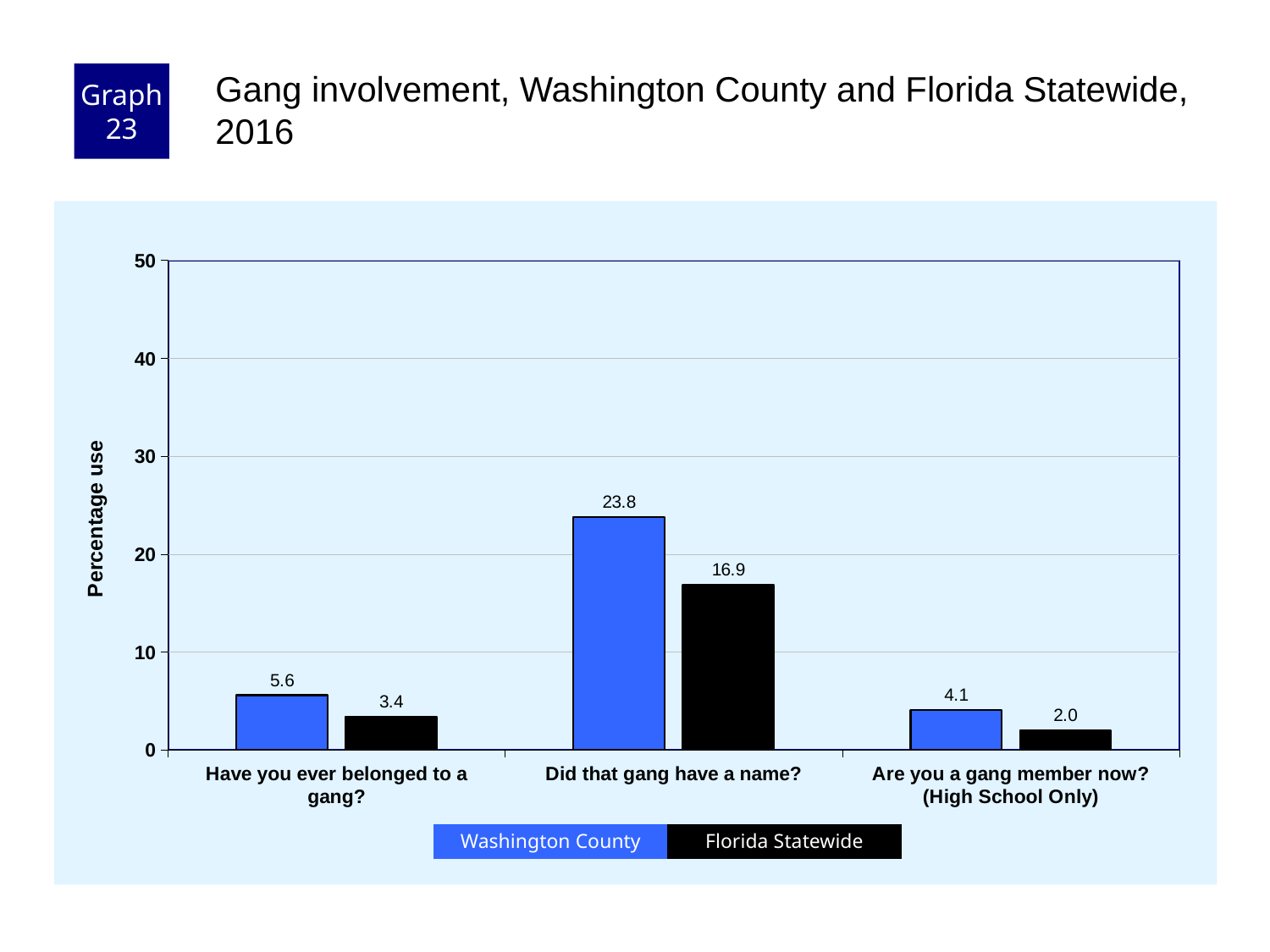
What is the Washington County value for "Did that gang have a name?"? 23.8 What is the Florida Statewide value for "Have you ever belonged to a gang?"? 3.4 How many survey questions (categories) are shown on the x axis? 3 How many series does the legend list? 2 What is the difference between the Washington County and Florida Statewide values for "Did that gang have a name?"? 6.9 What is the label of the y axis? Percentage use Which question has the highest Washington County value? Did that gang have a name? What kind of chart is shown on the slide? Bar chart For "Have you ever belonged to a gang?", which is larger: Washington County or Florida Statewide? Washington County Which question has the lowest Florida Statewide value? Are you a gang member now? (High School Only) What is the Florida Statewide value for "Are you a gang member now? (High School Only)"? 2.0 Is the Washington County value for "Did that gang have a name?" greater or less than 20? greater